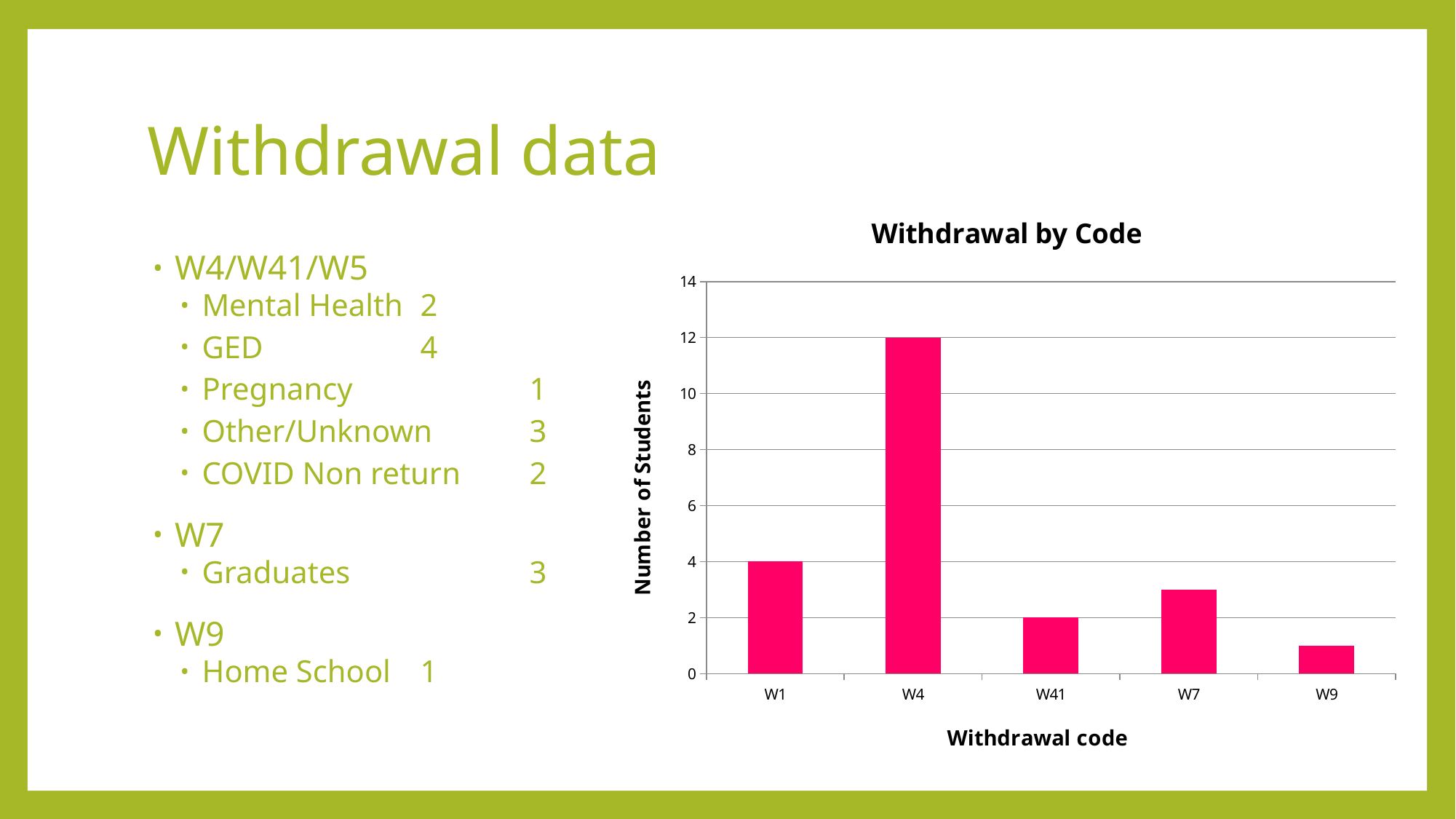
Is the value for W7 greater or less than 4? less How many withdrawal codes are shown on the x axis of the chart? 5 What is the difference in number of students between W4 and W1? 8 Which has more students, W1 or W41? W1 What is the title of the chart? Withdrawal by Code What is the number of students for withdrawal code W4? 12 What is the number of students for withdrawal code W41? 2 What type of chart is shown on the slide? bar chart What is the number of students for withdrawal code W1? 4 Which withdrawal code has the lowest number of students? W9 Is the value for W9 greater or less than 2? less Which withdrawal code has the highest number of students? W4